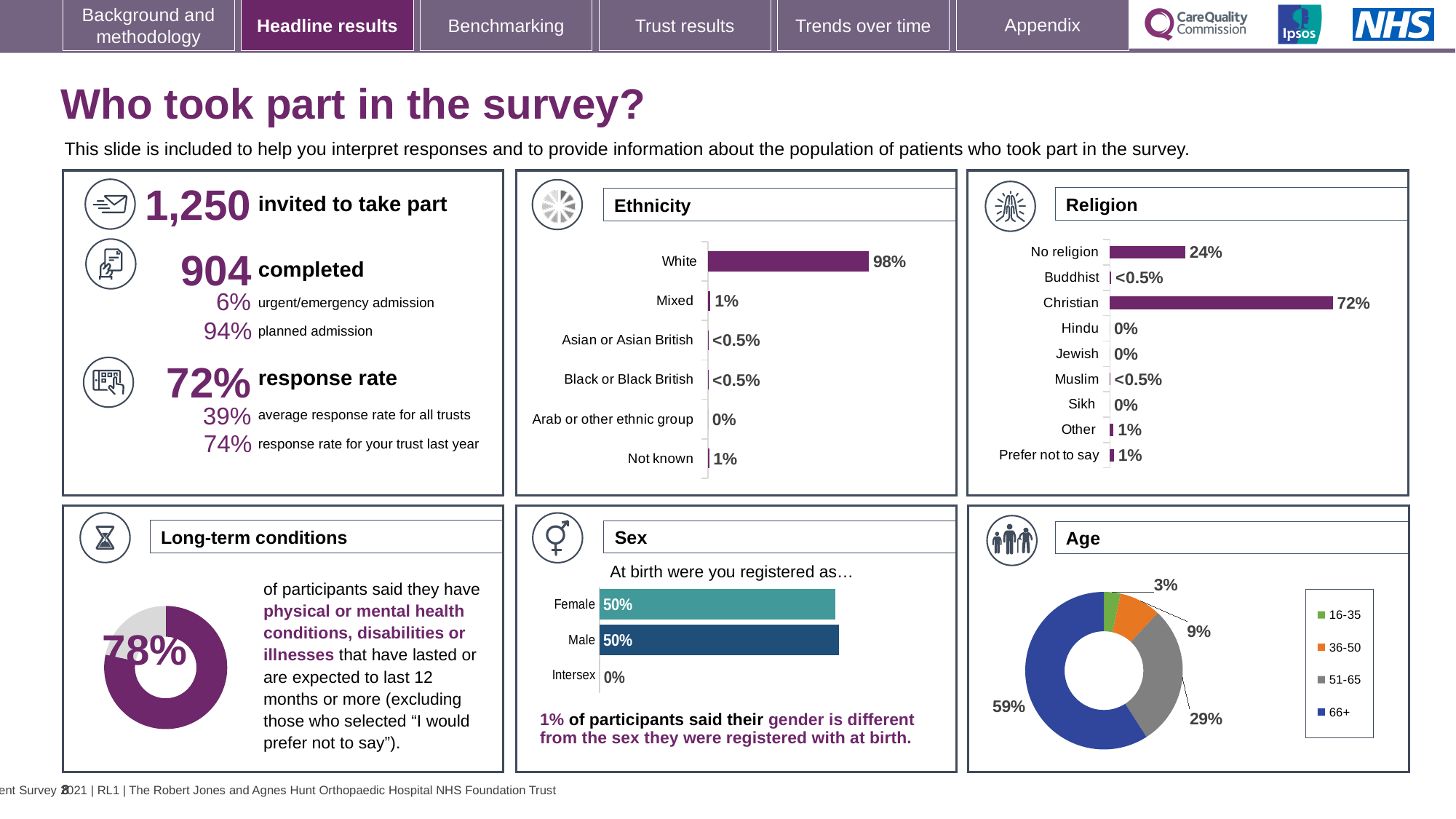
In the Ethnicity chart, which category has the highest value? White In the Religion chart, what is the value for Christian? 72% In the Ethnicity chart, what percentage of participants were White? 98% In the Sex chart, what is the value for Female? 50% In the Age chart, what share of participants were aged 66+? 59% What type of chart is used in the Age panel? Donut (pie) chart How many entries does the legend of the Age chart list? 4 How many categories are shown in the Ethnicity chart? 6 How many categories are listed in the Religion chart? 9 In the Religion chart, what is the difference between the Christian and No religion values? 48% In the Religion chart, what is the value for No religion? 24% In the Age chart, which age group has the smallest share? 16-35